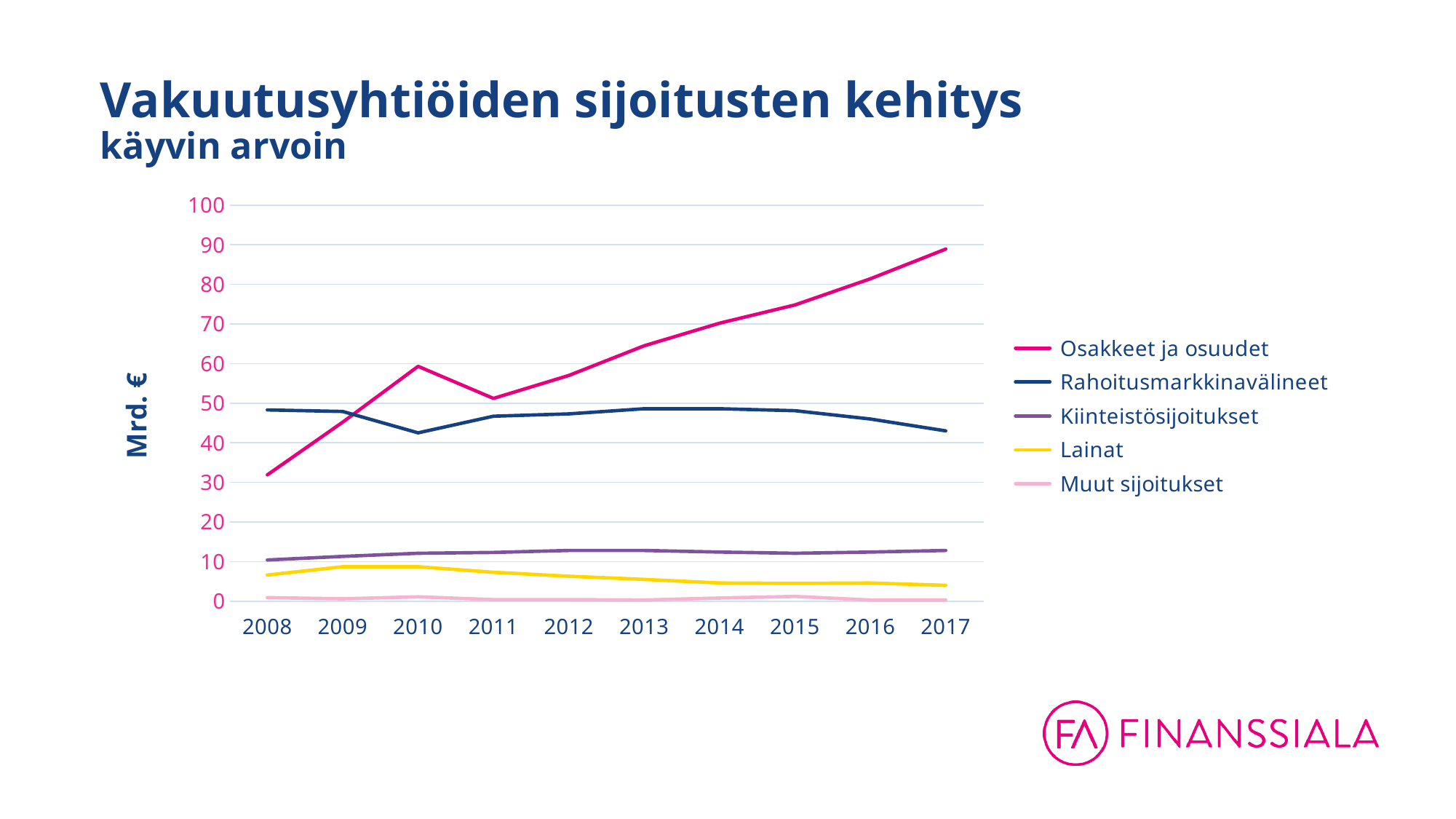
What kind of chart is shown on the slide? line chart What is the label on the y axis? Mrd. € Which series has the lowest value in 2017? Muut sijoitukset How many years are shown on the x axis? 10 Is the value for Lainat in 2017 greater or less than 10? less Is the value for Osakkeet ja osuudet in 2017 greater or less than 80? greater Is the value for Rahoitusmarkkinavälineet in 2010 greater or less than 50? less How many series does the legend list? 5 Which series has the highest value in 2017? Osakkeet ja osuudet Does the Osakkeet ja osuudet line rise or fall from 2011 to 2017? rise In 2008, which is larger: Osakkeet ja osuudet or Rahoitusmarkkinavälineet? Rahoitusmarkkinavälineet